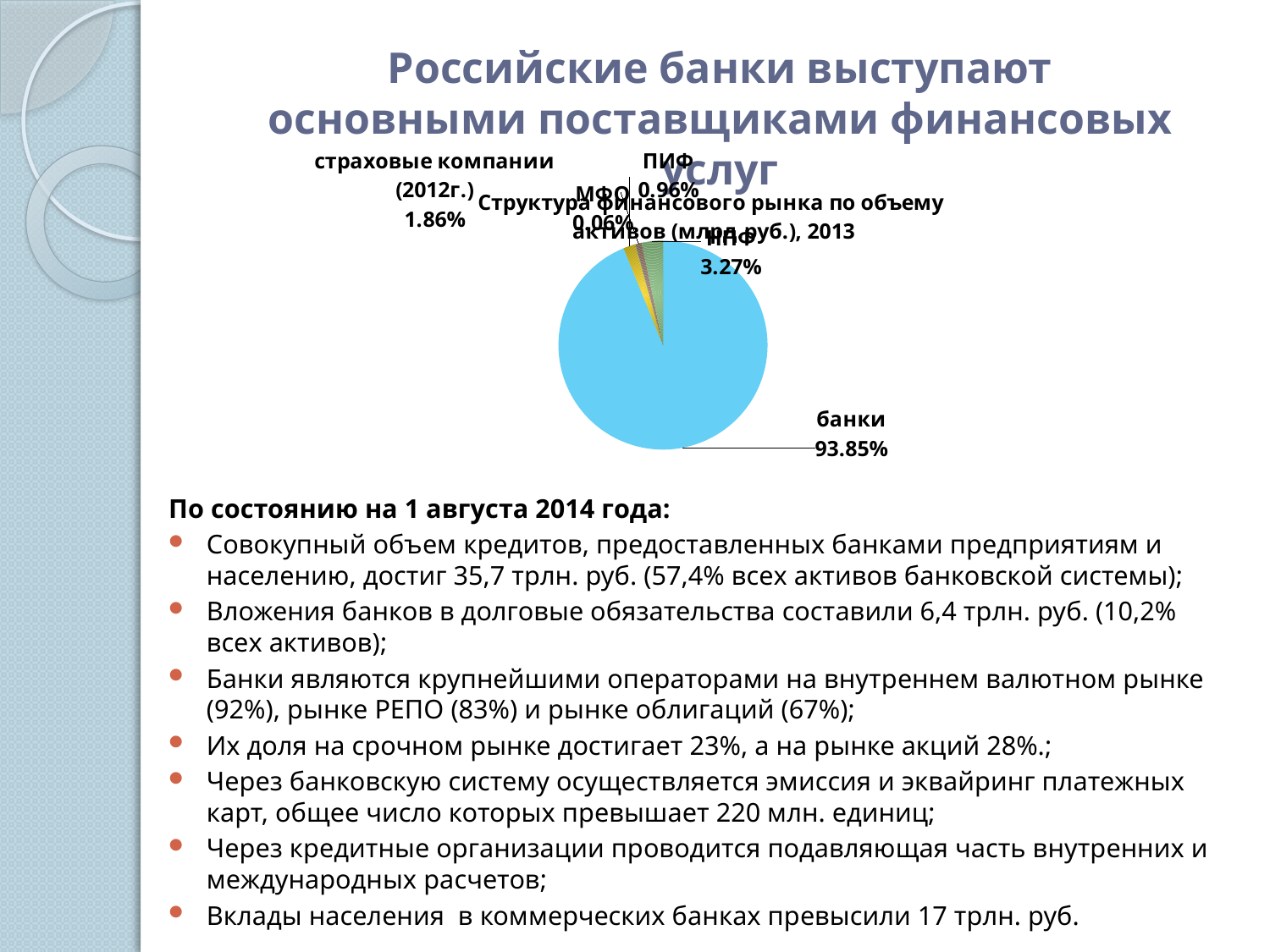
What share of the pie does НПФ hold? 3.27% What is the title of the pie chart? Структура финансового рынка по объему активов (млрд.руб.), 2013 What share of the pie does ПИФ hold? 0.96% How many slices does the pie chart have? 5 What is the difference in percentage points between the share for НПФ and the share for страховые компании (2012г.)? 1.41 What share of the pie does банки hold? 93.85% Which category has the largest slice of the pie? банки Which category has the smallest slice of the pie? МФО What kind of chart is shown on the slide? pie chart Which is larger, the share for НПФ or the share for ПИФ? НПФ